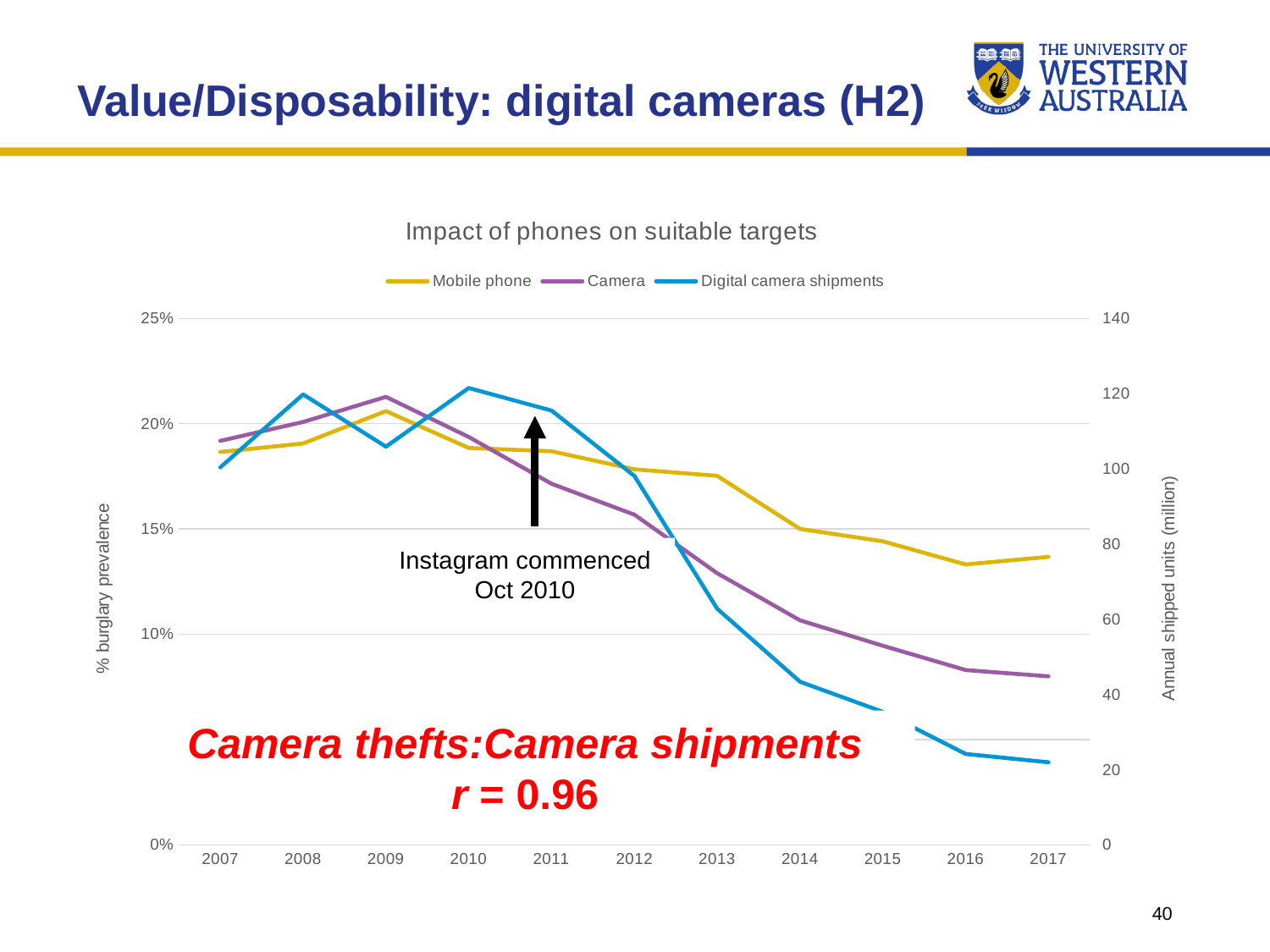
Is the Digital camera shipments value for 2017 greater or less than 40 million? less Is the Digital camera shipments value for 2010 greater or less than 100 million? greater How many series does the chart legend list? 3 What kind of chart is shown on the slide? Line chart In which year does the Camera series reach its highest value? 2009 Which series is plotted in blue? Digital camera shipments What is the title of the chart? Impact of phones on suitable targets Is the Mobile phone value for 2017 greater or less than 15%? less In 2015, which series has the higher burglary prevalence, Mobile phone or Camera? Mobile phone Does the Camera series rise or fall between 2009 and 2017? Fall How many years are shown along the x axis of the chart? 11